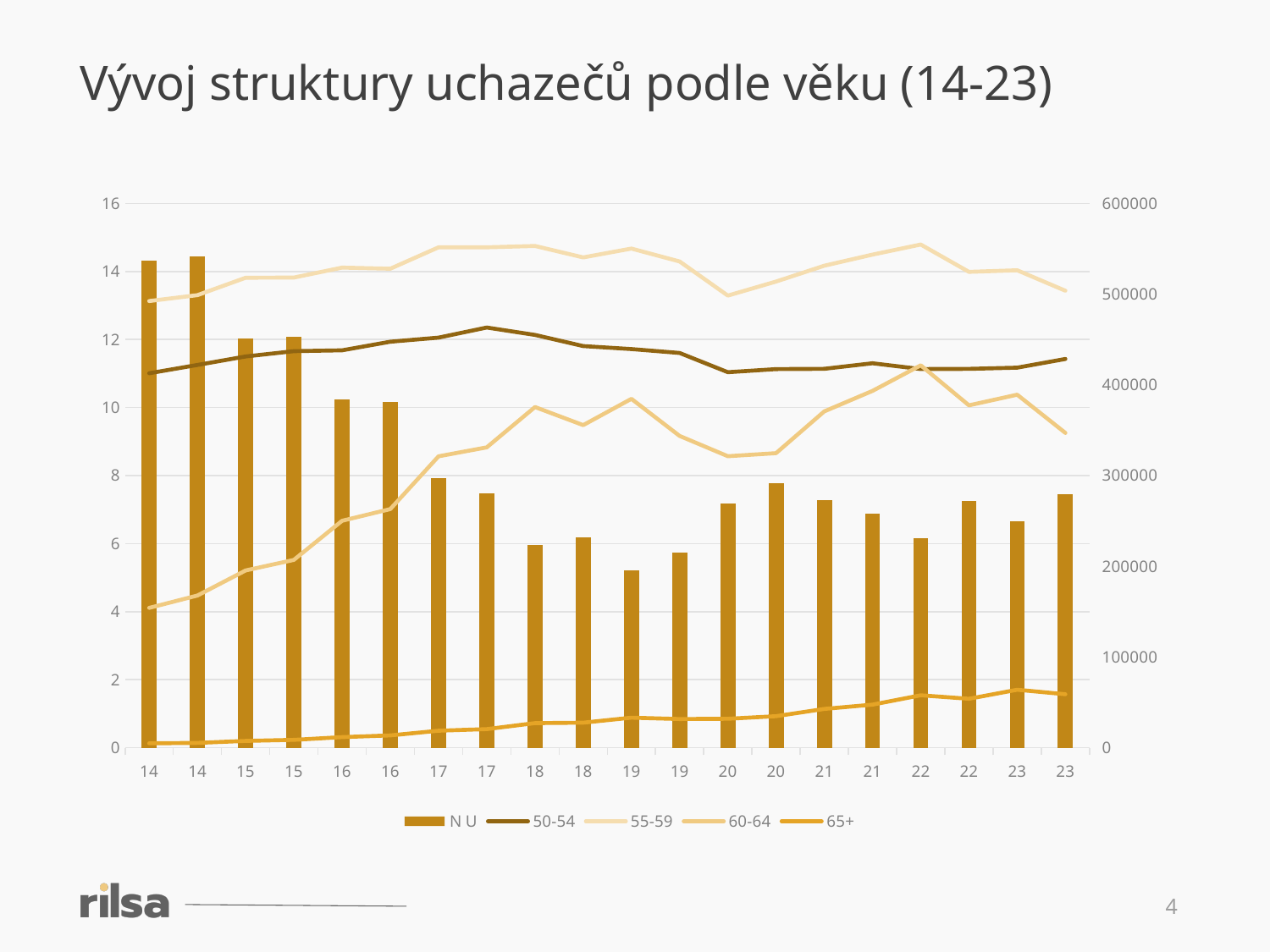
What is the title of the chart? Vývoj struktury uchazečů podle věku (14-23) Is the value of the 65+ line at the last point (23) greater or less than 100000? less How many bars are plotted in the chart? 20 Which line series has the lowest values across the chart? 65+ Which line series has the highest values across the chart? 55-59 Which series is drawn as bars? N U Is the value of the first N U bar labelled 14 greater or less than 12? greater Does the 65+ line rise or fall along the x axis from 14 to 23? rise What kind of chart is this? Combined bar and line chart How many series does the legend list? 5